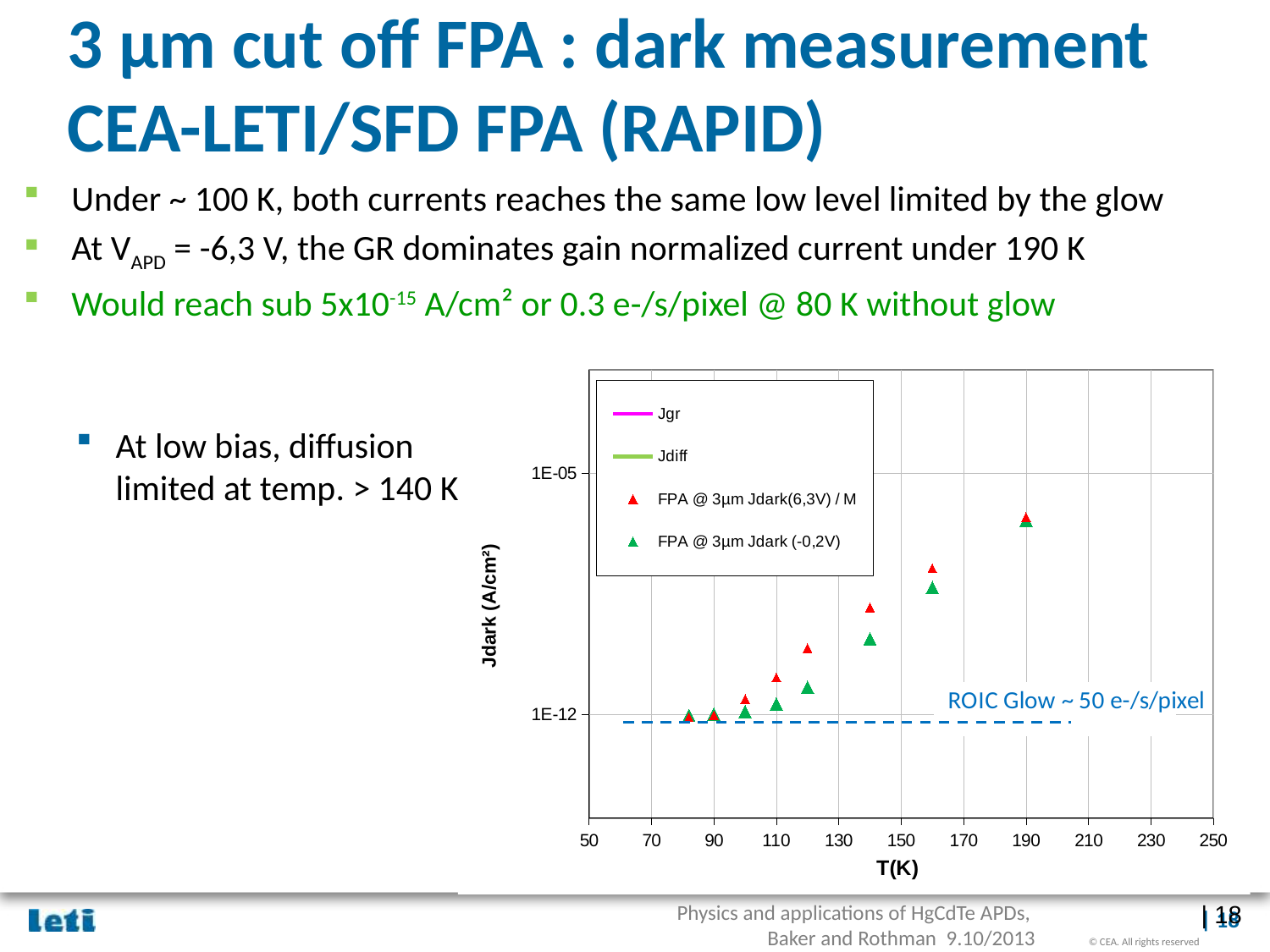
At which temperature does the FPA @ 3µm Jdark(6,3V) / M series reach its highest value? 190 K Is the FPA @ 3µm Jdark(6,3V) / M value at 190 K greater or less than 1E-05? less How many data points are plotted for the FPA @ 3µm Jdark(6,3V) / M series? 8 What is the label of the y axis of the chart? Jdark (A/cm²) What kind of chart is shown on the slide? scatter chart What is the highest temperature tick shown on the x axis? 250 Do the plotted Jdark values rise or fall as T(K) increases? rise What is the lowest temperature tick shown on the x axis? 50 Is the FPA @ 3µm Jdark (-0,2V) value at 160 K greater or less than 1E-12? greater How many series does the chart legend list? 4 At 140 K, which series has the larger Jdark value: FPA @ 3µm Jdark(6,3V) / M or FPA @ 3µm Jdark (-0,2V)? FPA @ 3µm Jdark(6,3V) / M What is the label of the x axis of the chart? T(K)